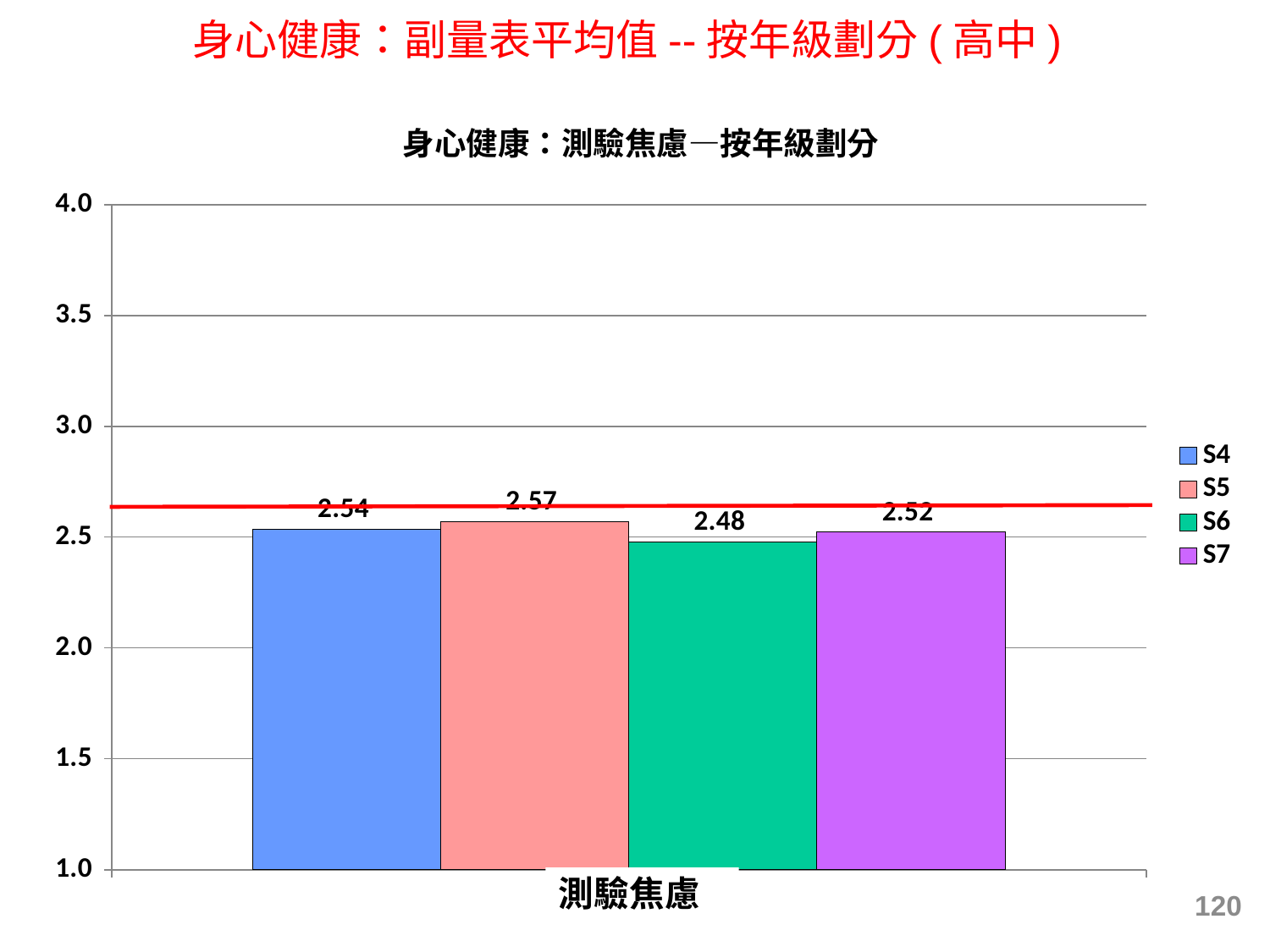
What is the value for S7 in the chart? 2.52 Is the value for S5 greater or less than 3.0? less What is the value for S5 in the chart? 2.57 Which series has the lowest value in the chart? S6 What is the value for S4 in the chart? 2.54 What is the value for S6 in the chart? 2.48 Which series has the highest value in the chart? S5 What is the title of the chart? 身心健康：測驗焦慮—按年級劃分 What is the difference between the values for S5 and S6? 0.09 How many series does the legend list? 4 Which is larger, the value for S4 or the value for S7? S4 What kind of chart is shown on the slide? bar chart